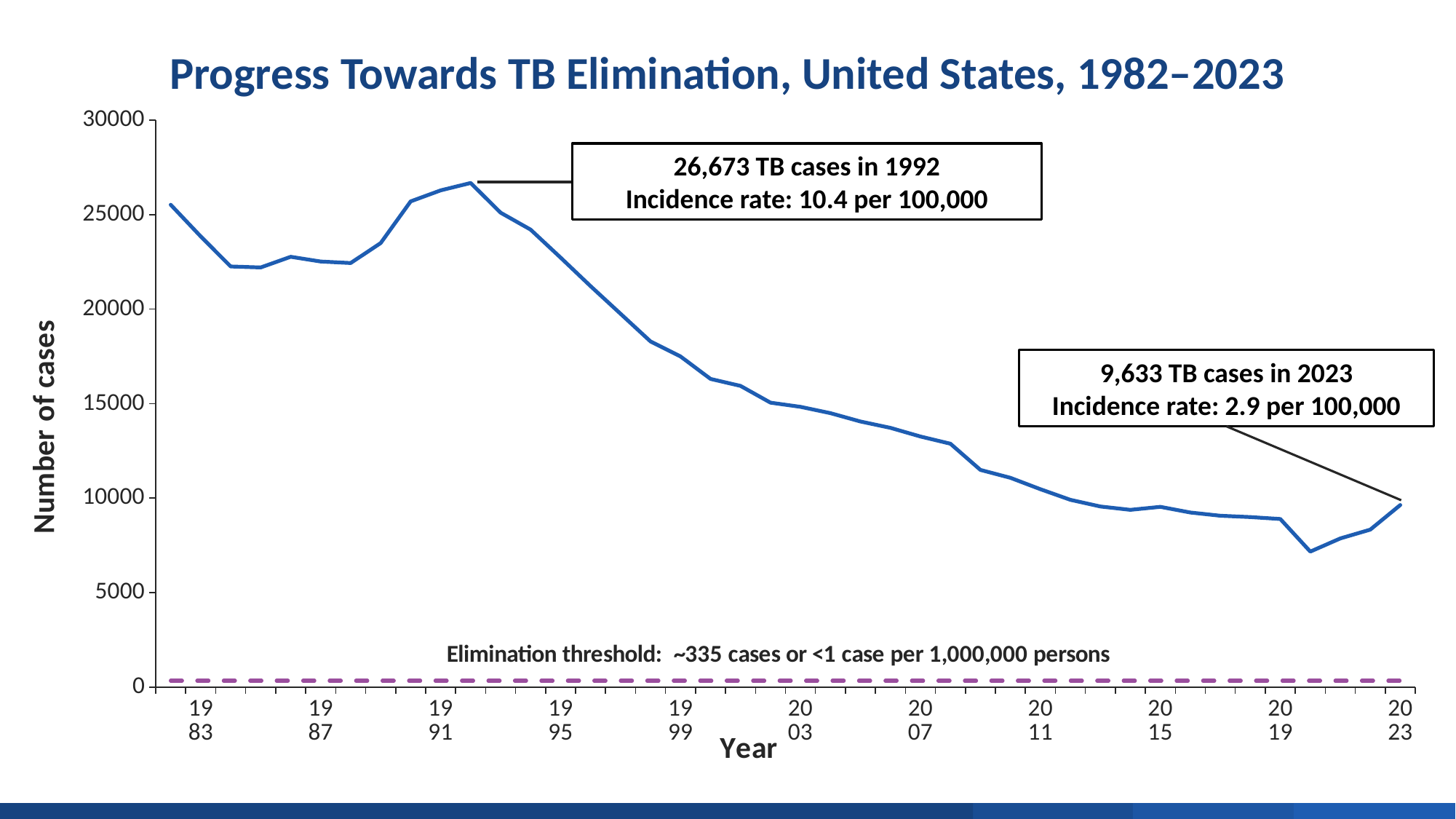
What is the difference between the number of TB cases in 1992 and in 2023? 17,040 How many TB cases were reported in 2023 according to the callout? 9,633 What was the TB incidence rate in 1992? 10.4 per 100,000 How many TB cases were reported in 1992 according to the callout? 26,673 In which year does the line reach its highest number of cases? 1992 Is the number of cases in 2011 greater or less than 15000? less Which year had more TB cases, 1992 or 2023? 1992 What does the dashed purple line at the bottom of the chart represent? Elimination threshold What type of chart is shown on the slide? Line chart Is the number of cases in 1983 greater or less than 20000? greater What was the TB incidence rate in 2023? 2.9 per 100,000 Does the number of TB cases rise or fall from 1992 to 2023? Fall